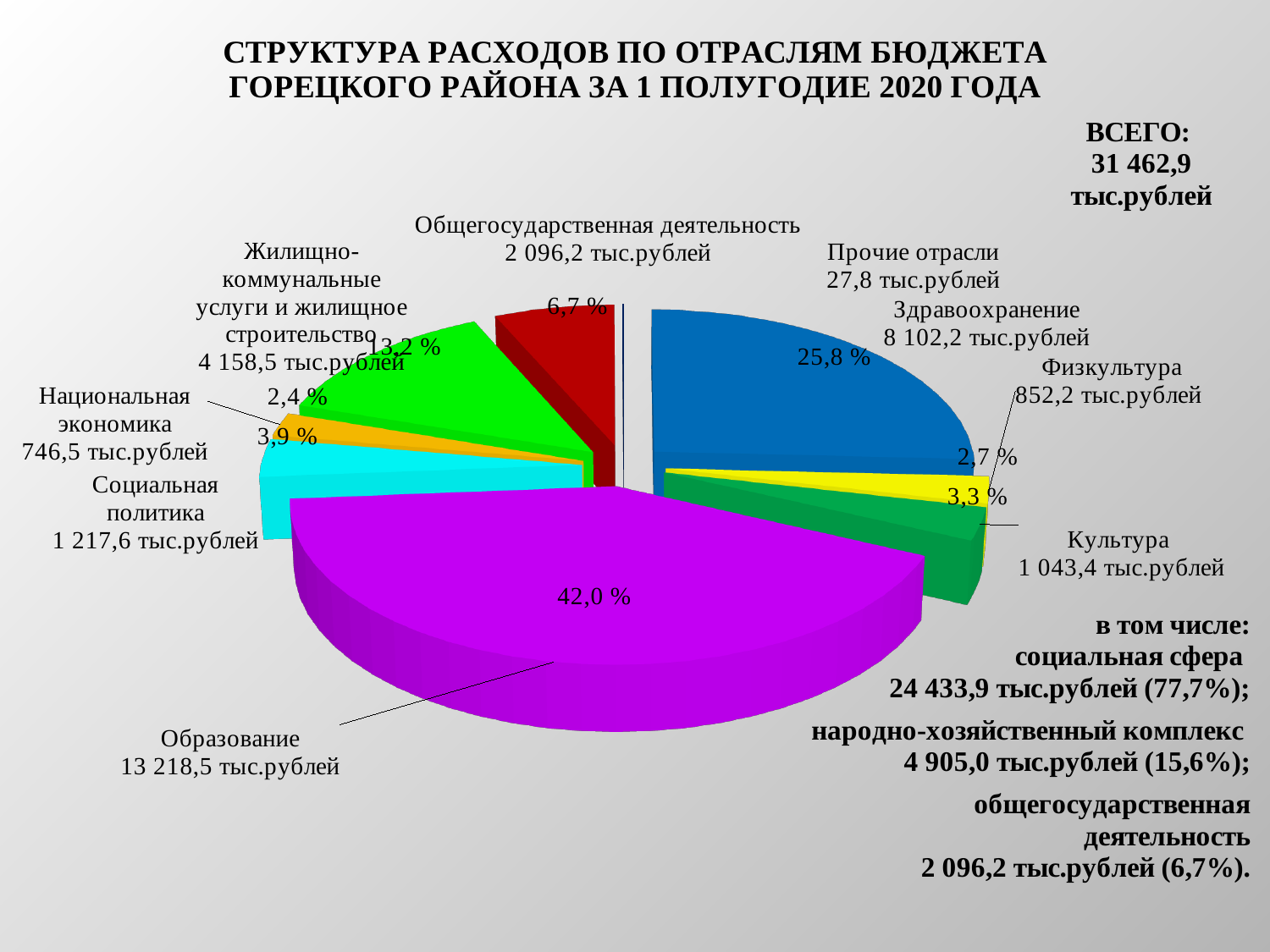
How many categories are shown in the pie chart? 9 Which is larger, the value for Культура or the value for Физкультура? Культура What is the value for Образование? 13 218,5 тыс.рублей What share of the pie does Общегосударственная деятельность take? 6,7 % Which category has the smallest slice of the pie? Прочие отрасли What share of the pie does Здравоохранение take? 25,8 % What kind of chart is shown on the slide? pie chart What total is stated on the slide (ВСЕГО)? 31 462,9 тыс.рублей What is the value for Национальная экономика? 746,5 тыс.рублей What is the difference between the values for Здравоохранение and Образование? 5 116,3 тыс.рублей What is the value for Жилищно-коммунальные услуги и жилищное строительство? 4 158,5 тыс.рублей Which category has the largest slice of the pie? Образование